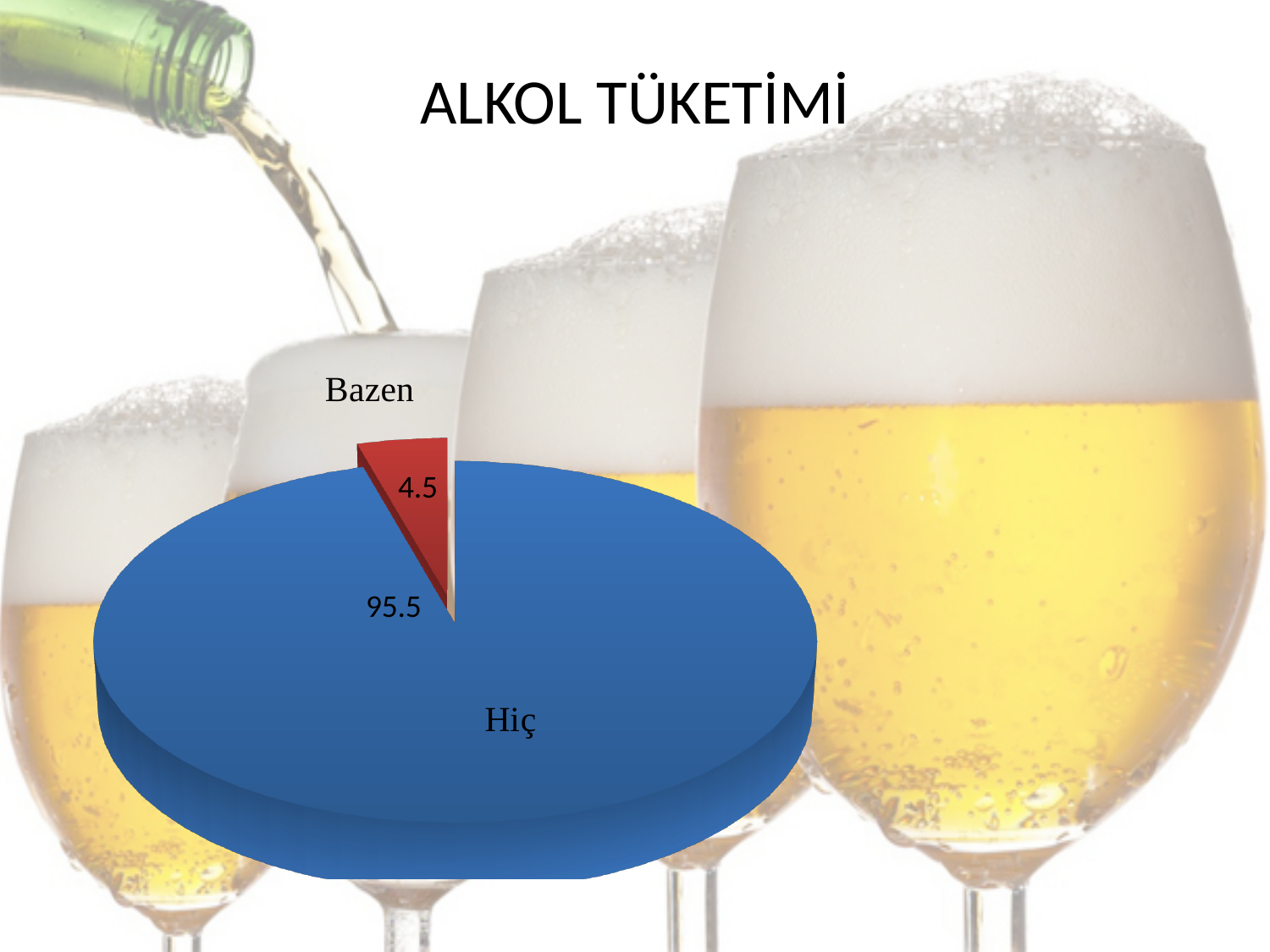
Which is larger, the value for Hiç or the value for Bazen? Hiç What is the title of the slide? ALKOL TÜKETİMİ Which category has the largest slice? Hiç What colour is the Bazen slice? red What is the value for Hiç? 95.5 How many slices does the pie chart have? 2 What is the difference between the values for Hiç and Bazen? 91 Which category has the smallest slice? Bazen What is the total of the two slice values? 100 What kind of chart is shown on the slide? pie chart What is the value for Bazen? 4.5